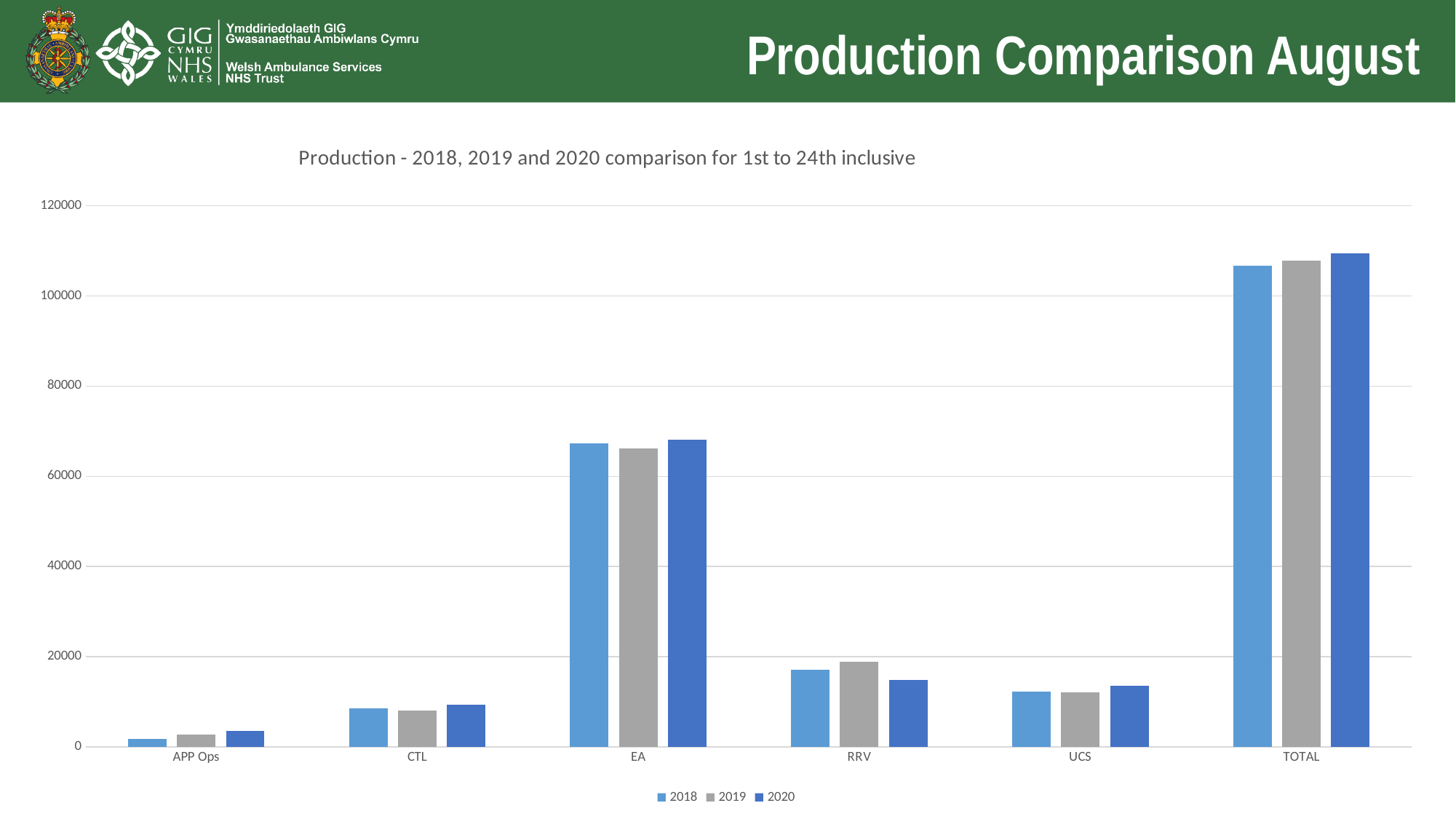
Is the 2018 value for EA greater or less than 60000? greater Which is larger for 2018: the value for RRV or the value for UCS? RRV Is the 2019 value for RRV greater or less than 20000? less Is the 2020 value for TOTAL greater or less than 100000? greater How many series does the chart's legend list? 3 How many categories are shown on the x axis of the chart? 6 For RRV, which series has the highest bar? 2019 Which category has the lowest bars in the chart? APP Ops Which category, excluding TOTAL, has the highest bars in the chart? EA What kind of chart is shown on the slide? bar chart What is the title of the chart? Production - 2018, 2019 and 2020 comparison for 1st to 24th inclusive